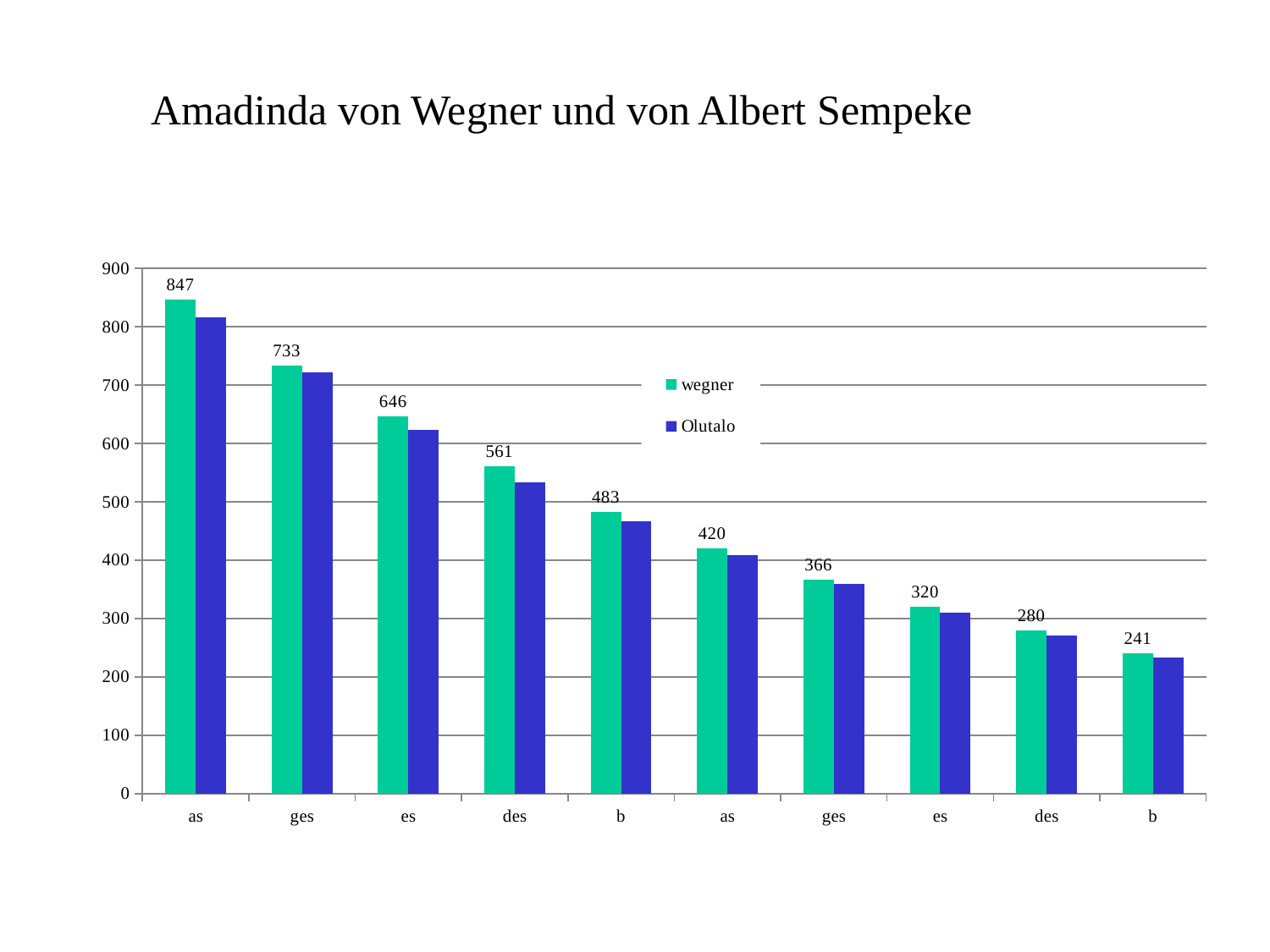
How many series does the legend list? 2 Which category has the lowest wegner value? the last "b" (rightmost) Do the wegner values rise or fall from left to right along the x axis? fall How many categories are shown on the x axis? 10 What is the wegner value for the first "as" category? 847 What is the wegner value for the first "des" category? 561 What is the wegner value for the last "b" category (rightmost)? 241 What kind of chart is shown on the slide? bar chart Is the Olutalo value for the first "as" category greater or less than 800? greater Which category has the highest wegner value? the first "as" (leftmost) What is the difference between the wegner values for the first "as" and the first "ges"? 114 For the first "as" category, which series has the larger value, wegner or Olutalo? wegner